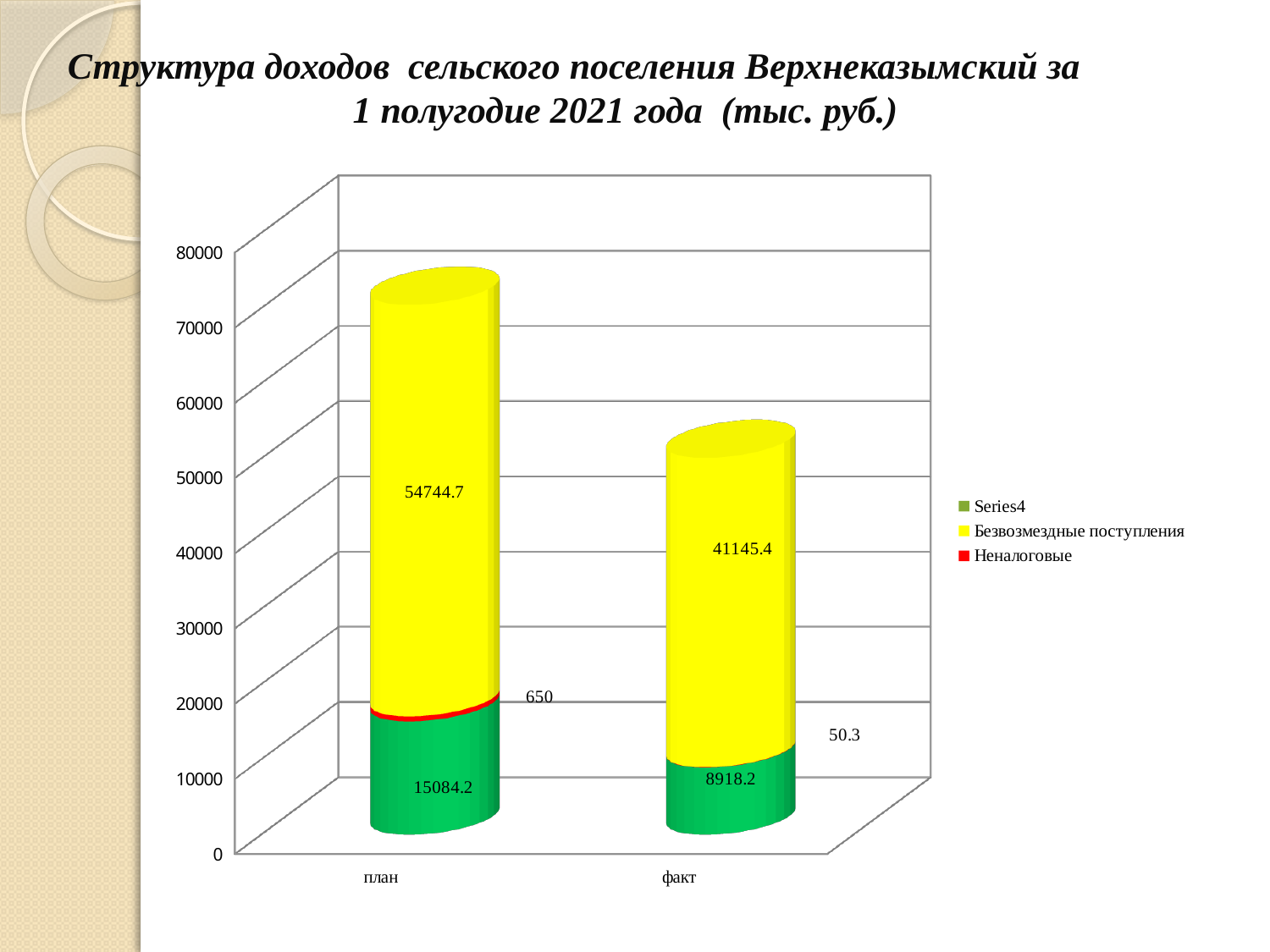
What is the value of Series4 for план? 15084.2 What is the value of Безвозмездные поступления for план? 54744.7 What is the total of the stacked bar for план? 70478.9 What is the total of the stacked bar for факт? 50113.9 How many categories are shown on the x axis? 2 What is the difference between the Безвозмездные поступления values for план and факт? 13599.3 What is the difference between the Series4 values for план and факт? 6166 What is the value of Неналоговые for план? 650 Which category has the larger Series4 value, план or факт? план What is the value of Безвозмездные поступления for факт? 41145.4 What is the value of Неналоговые for факт? 50.3 How many series does the legend list? 3